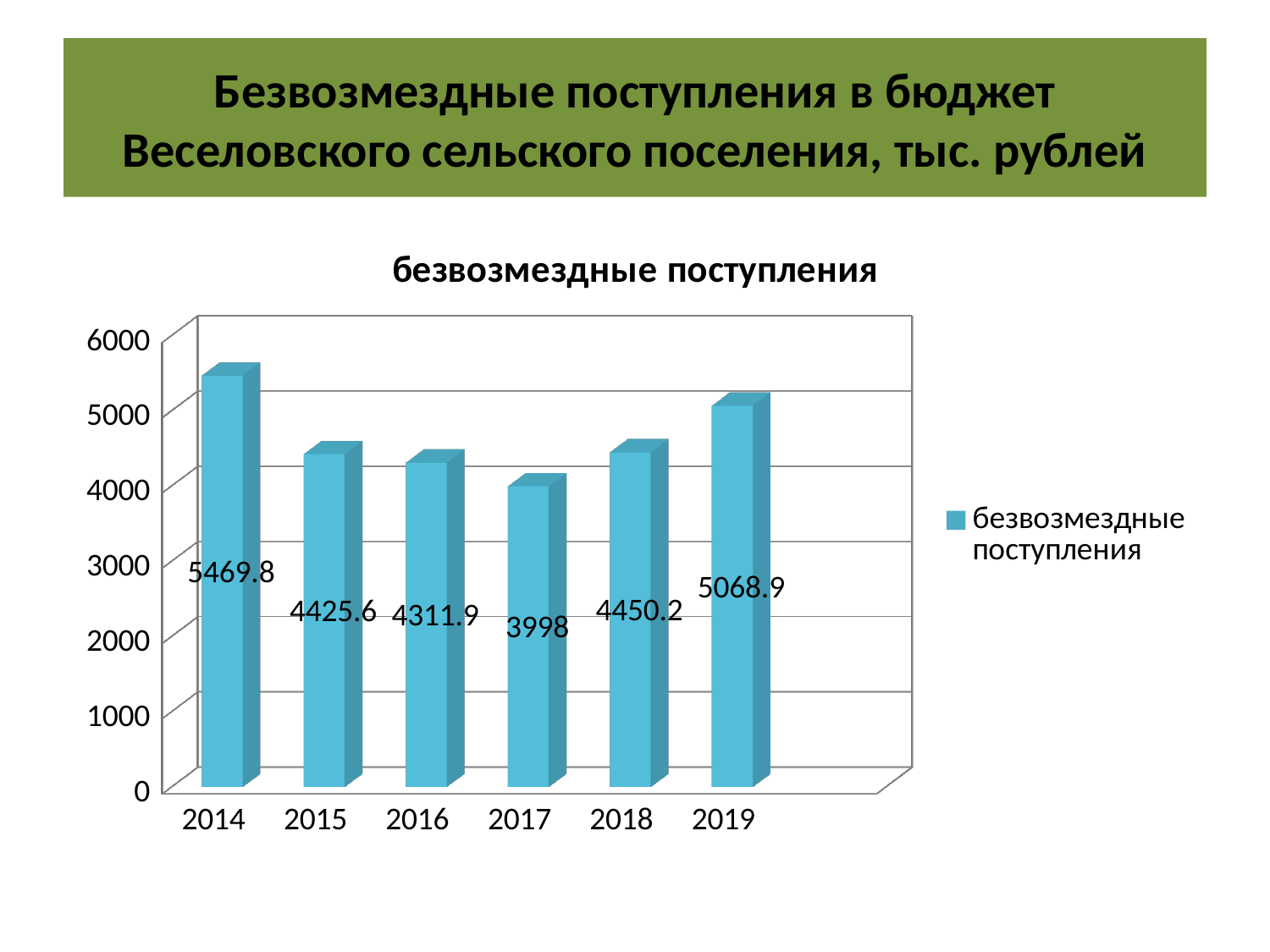
Which year has the lowest value? 2017 Is the value for 2019 greater or less than 5000? greater What is the title of the chart? безвозмездные поступления Which year has the highest value? 2014 What is the value for 2017? 3998 How many years are shown on the x axis? 6 What is the difference between the values for 2014 and 2019? 400.9 Which is larger, the value for 2015 or the value for 2016? 2015 What is the value for 2014? 5469.8 What is the difference between the values for 2018 and 2017? 452.2 What kind of chart is this? bar chart What is the value for 2019? 5068.9